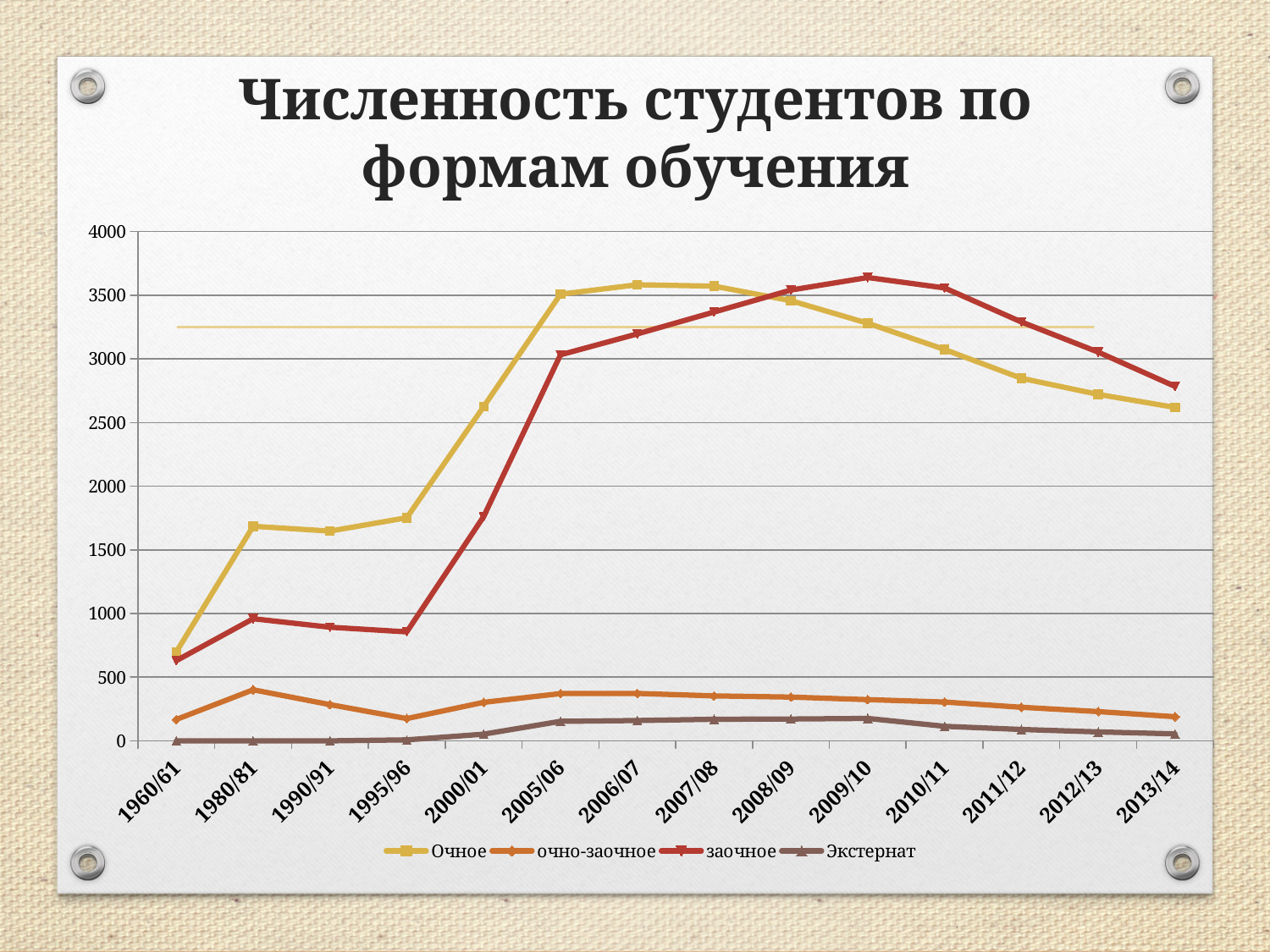
What type of chart is shown on the slide? line chart Is the value for очно-заочное in 1980/81 greater or less than 500? less Is the value for Очное in 2006/07 greater or less than 3000? greater Is the value for заочное in 2009/10 greater or less than 3500? greater Does the Очное series rise or fall from 2006/07 to 2013/14? fall How many academic years are shown on the x axis? 14 How many series does the legend list? 4 What is the title of the chart? Численность студентов по формам обучения In 2005/06, which is larger: Очное or заочное? Очное In 2013/14, which is larger: Очное or заочное? заочное In which academic year does the заочное series reach its highest value? 2009/10